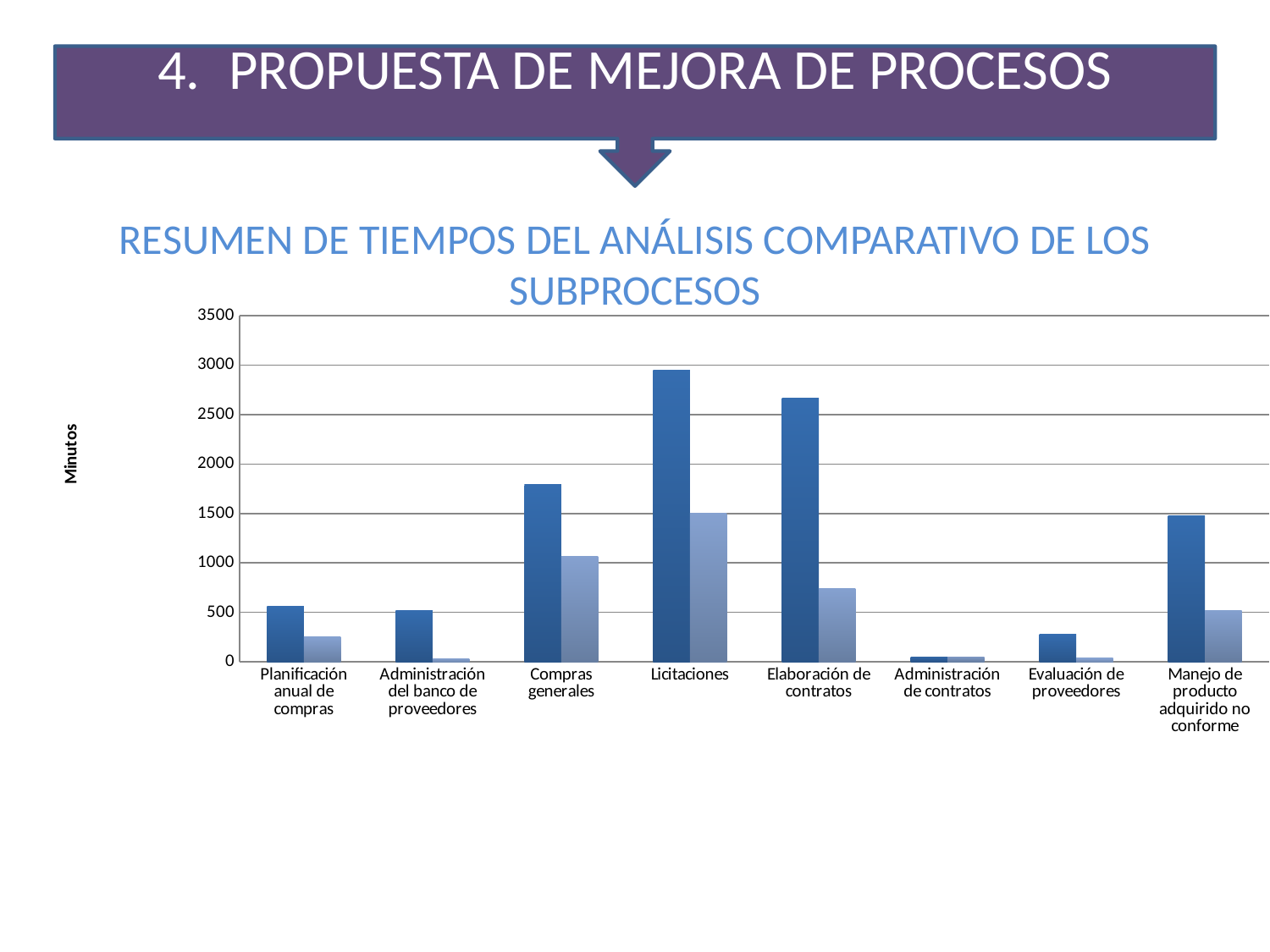
How many bars are plotted for each category in the chart? 2 Is the dark blue bar for Compras generales greater or less than 1500? greater Is the dark blue bar for Licitaciones greater or less than 2500? greater How many subprocess categories are shown on the x axis of the chart? 8 Is the light blue bar for Licitaciones greater or less than 1000? greater Which category has the lowest dark blue bar? Administración de contratos Which has the taller dark blue bar, Compras generales or Manejo de producto adquirido no conforme? Compras generales What is the label on the vertical axis of the chart? Minutos Which has the taller dark blue bar, Licitaciones or Elaboración de contratos? Licitaciones What kind of chart is shown on the slide? bar chart Which category has the tallest dark blue bar? Licitaciones